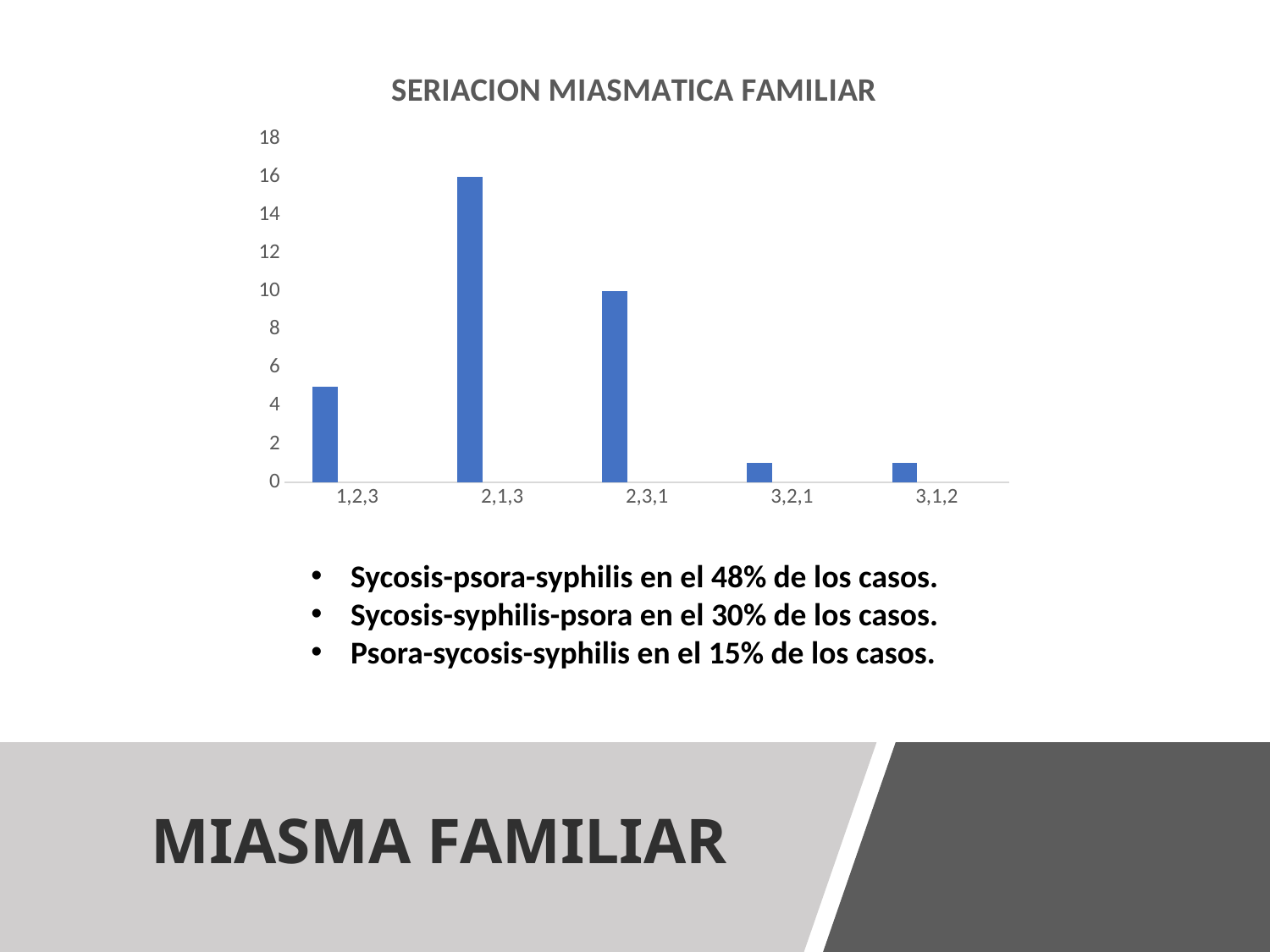
Is the value for 1,2,3 greater or less than 4? greater What is the value for the category 2,3,1? 10 Is the value for 3,2,1 greater or less than 2? less Which has the larger value, 2,1,3 or 3,2,1? 2,1,3 What colour are the bars in the chart? blue What kind of chart is shown on the slide? bar chart What is the value for the category 2,1,3? 16 What is the title of the chart? SERIACION MIASMATICA FAMILIAR What is the difference between the values for 2,1,3 and 2,3,1? 6 Which category has the highest value? 2,1,3 How many categories are shown on the x axis of the chart? 5 Which has the larger value, 1,2,3 or 2,3,1? 2,3,1